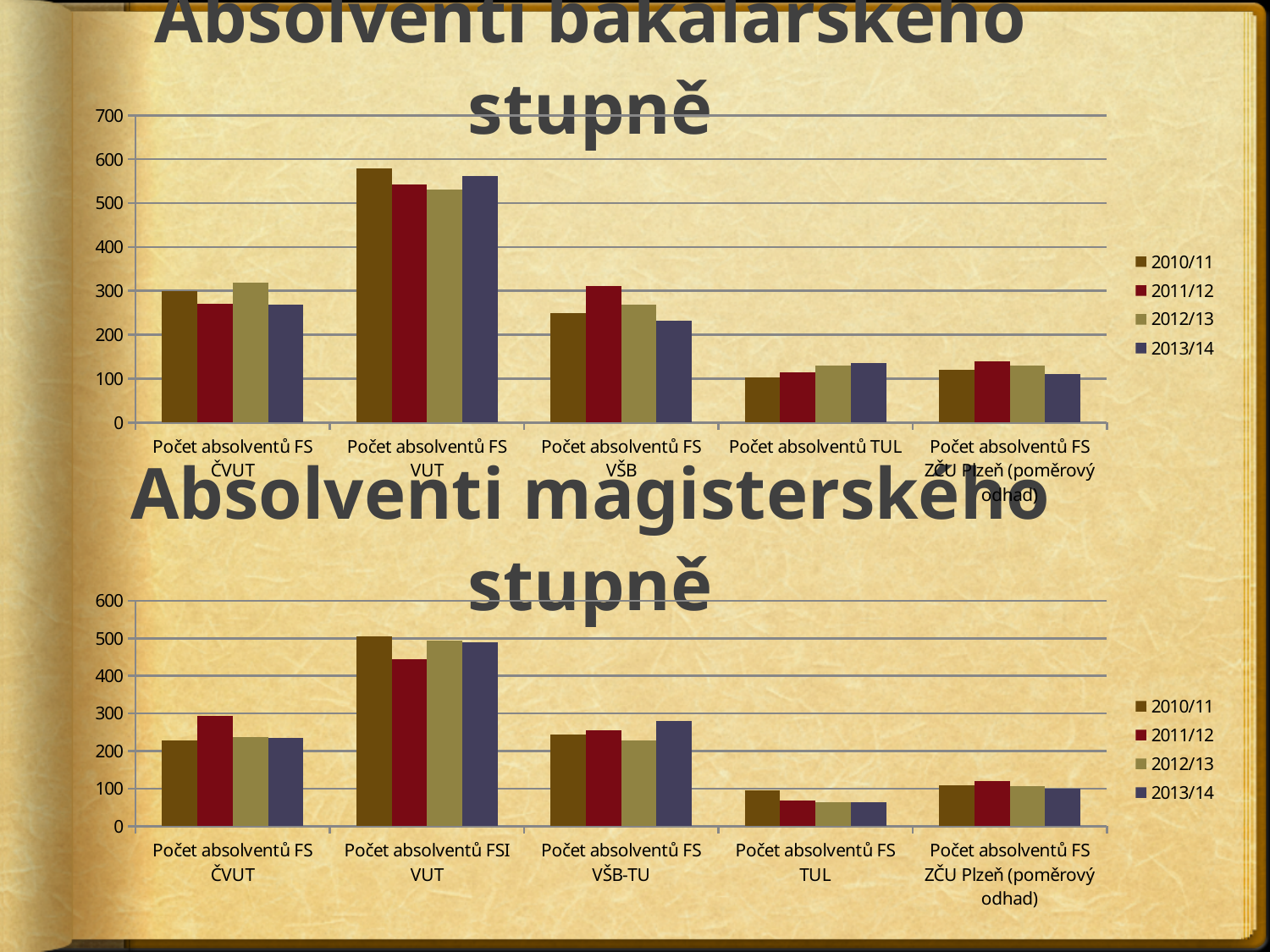
In the bottom chart, 'Absolventi magisterského stupně', which is larger for Počet absolventů FS ČVUT: the 2010/11 value or the 2011/12 value? 2011/12 What is the first series listed in the legend of the top chart, 'Absolventi bakalářského stupně'? 2010/11 In the top chart, 'Absolventi bakalářského stupně', which category has the highest bars overall? Počet absolventů FS VUT In the top chart, 'Absolventi bakalářského stupně', is the 2010/11 value for Počet absolventů FS VUT greater or less than 500? greater In the top chart, 'Absolventi bakalářského stupně', which is larger for Počet absolventů FS VŠB: the 2011/12 value or the 2013/14 value? 2011/12 What kind of chart is the top chart, 'Absolventi bakalářského stupně'? bar chart In the top chart, 'Absolventi bakalářského stupně', is the 2013/14 value for Počet absolventů TUL greater or less than 200? less How many categories are shown on the x axis of the top chart, 'Absolventi bakalářského stupně'? 5 In the bottom chart, 'Absolventi magisterského stupně', is the 2013/14 value for Počet absolventů FS VŠB-TU greater or less than 200? greater How many series does the legend of the bottom chart, 'Absolventi magisterského stupně', list? 4 In the bottom chart, 'Absolventi magisterského stupně', which category has the lowest bars overall? Počet absolventů FS TUL